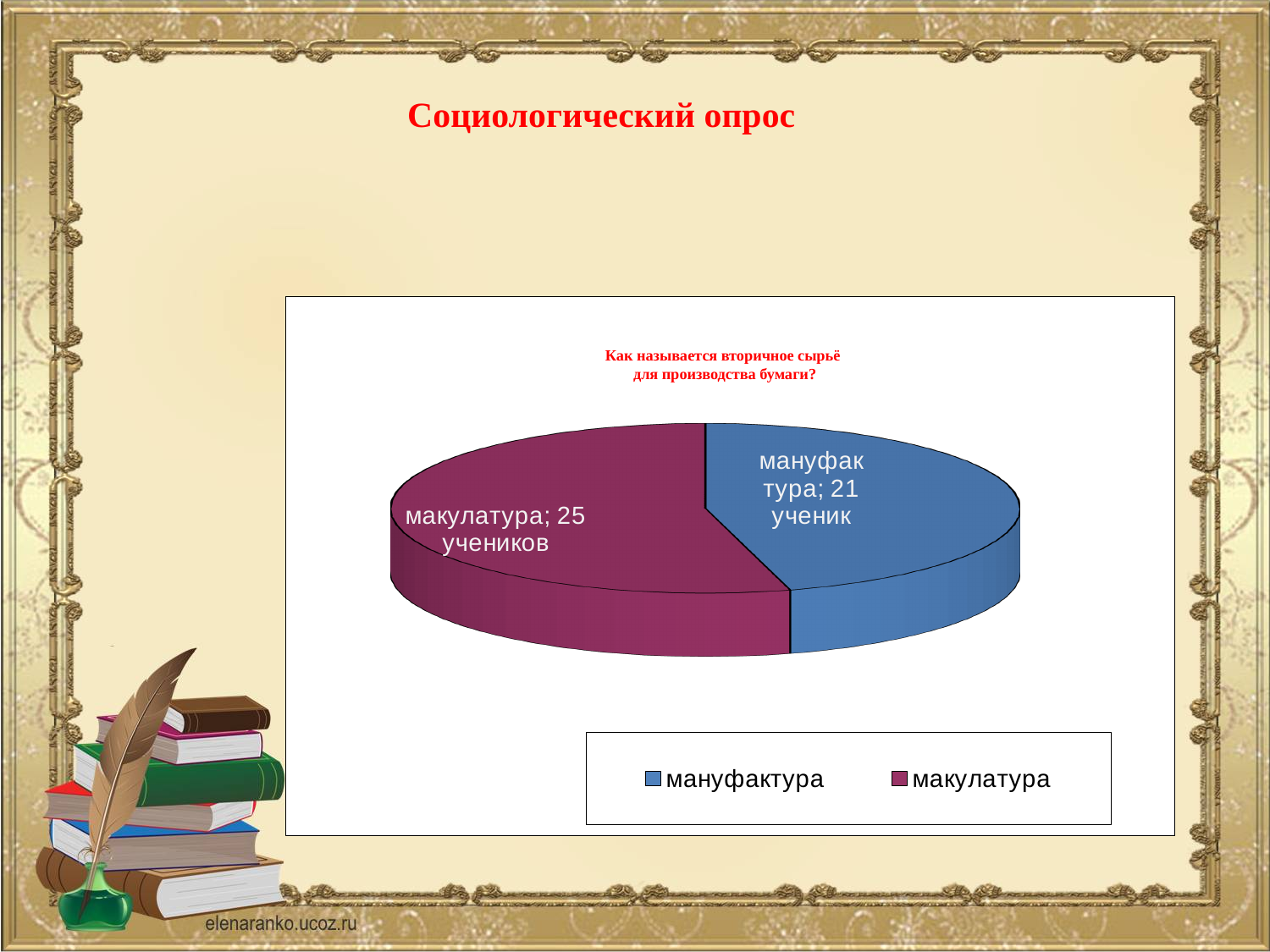
How many students answered "макулатура"? 25 учеников How many slices does the pie chart have? 2 Which answer received the fewest students? мануфактура What is the title of the chart? Как называется вторичное сырьё для производства бумаги? How many students answered "мануфактура"? 21 ученик Which colour represents "макулатура" in the chart? Purple (magenta) How many entries does the legend list? 2 What kind of chart is shown on the slide? Pie chart How many more students chose "макулатура" than "мануфактура"? 4 Which answer received the most students? макулатура Which is larger: the number of students who chose "мануфактура" or "макулатура"? макулатура What is the total number of students represented in the pie chart? 46